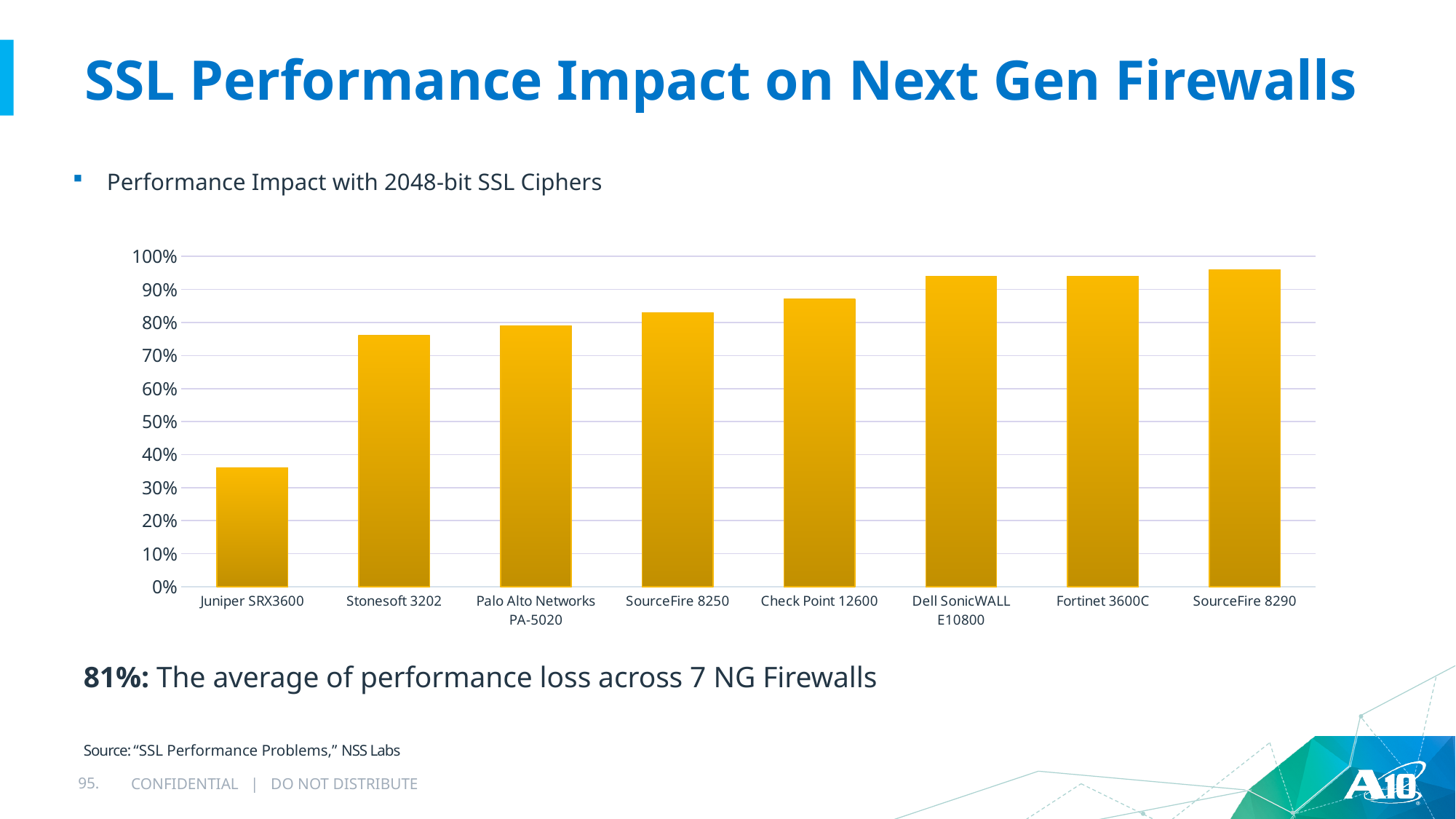
What is the caption given above the chart describing what it shows? Performance Impact with 2048-bit SSL Ciphers Which firewall has the lowest performance impact on the chart? Juniper SRX3600 Do the bar values generally rise or fall from left to right across the chart? Rise Is the value for Stonesoft 3202 greater or less than 70%? greater What kind of chart is shown on the slide? Bar chart Is the value for Dell SonicWALL E10800 greater or less than 90%? greater Is the value for Check Point 12600 greater or less than 90%? less How many firewalls (categories) are plotted on the chart? 8 Which has a larger value, Juniper SRX3600 or Stonesoft 3202? Stonesoft 3202 Which has a larger value, SourceFire 8250 or Check Point 12600? Check Point 12600